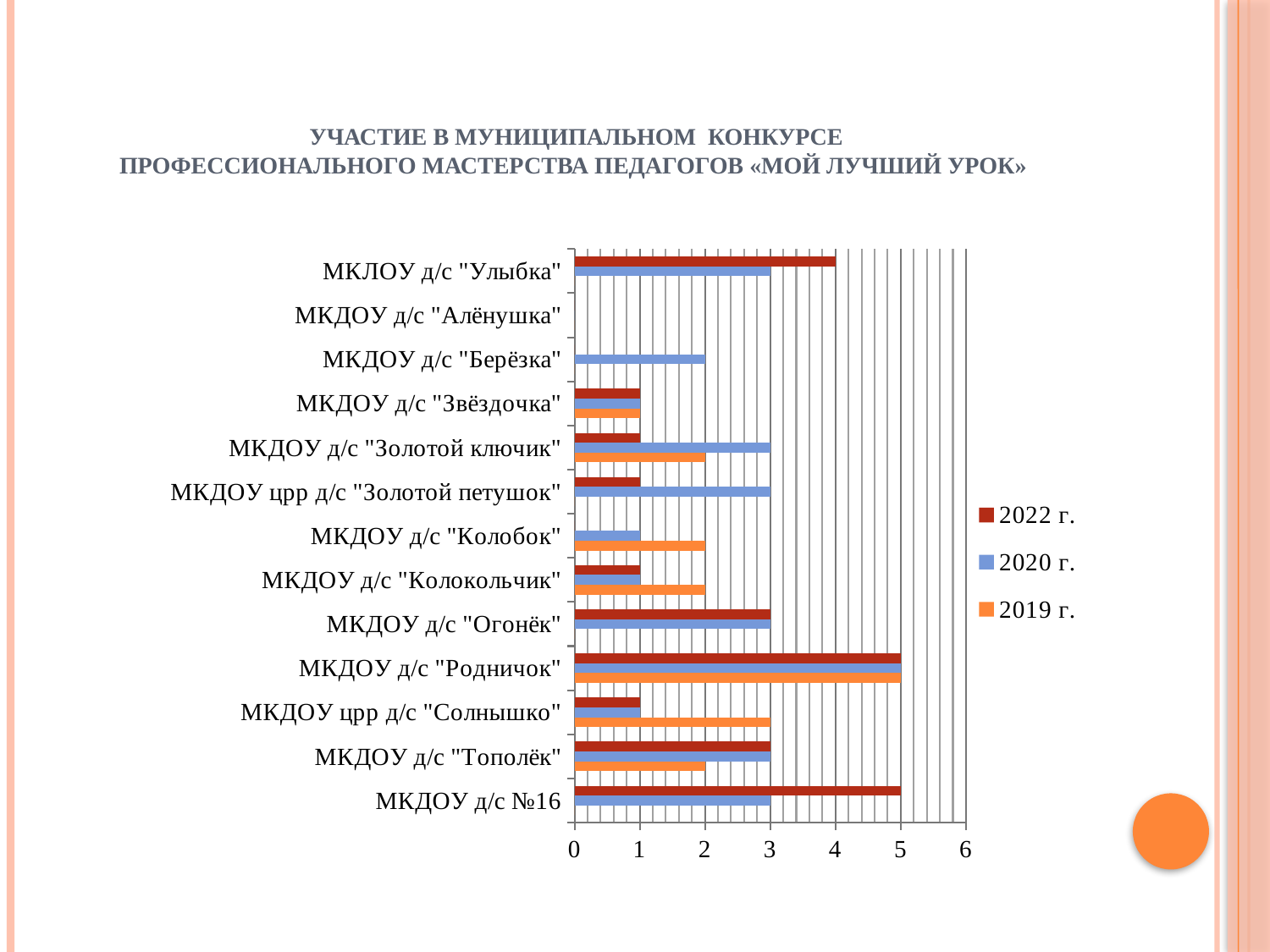
What is the difference between the 2022 г. and 2020 г. values for МКДОУ д/с №16? 2 How many kindergartens (categories) are listed on the vertical axis? 13 What kind of chart is shown on the slide? bar chart What is the value for МКДОУ црр д/с "Солнышко" in 2019 г.? 3 What is the value for МКЛОУ д/с "Улыбка" in 2022 г.? 4 Which is larger for МКДОУ д/с "Золотой ключик": the 2020 г. value or the 2022 г. value? 2020 г. How many series does the legend list? 3 Which kindergarten has the highest value in 2019 г.? МКДОУ д/с "Родничок" What is the value for МКДОУ д/с "Родничок" in 2019 г.? 5 What is the value for МКДОУ д/с №16 in 2020 г.? 3 Is the 2022 г. value for МКДОУ д/с "Родничок" greater or less than 4? greater Which legend entry is shown in orange? 2019 г.